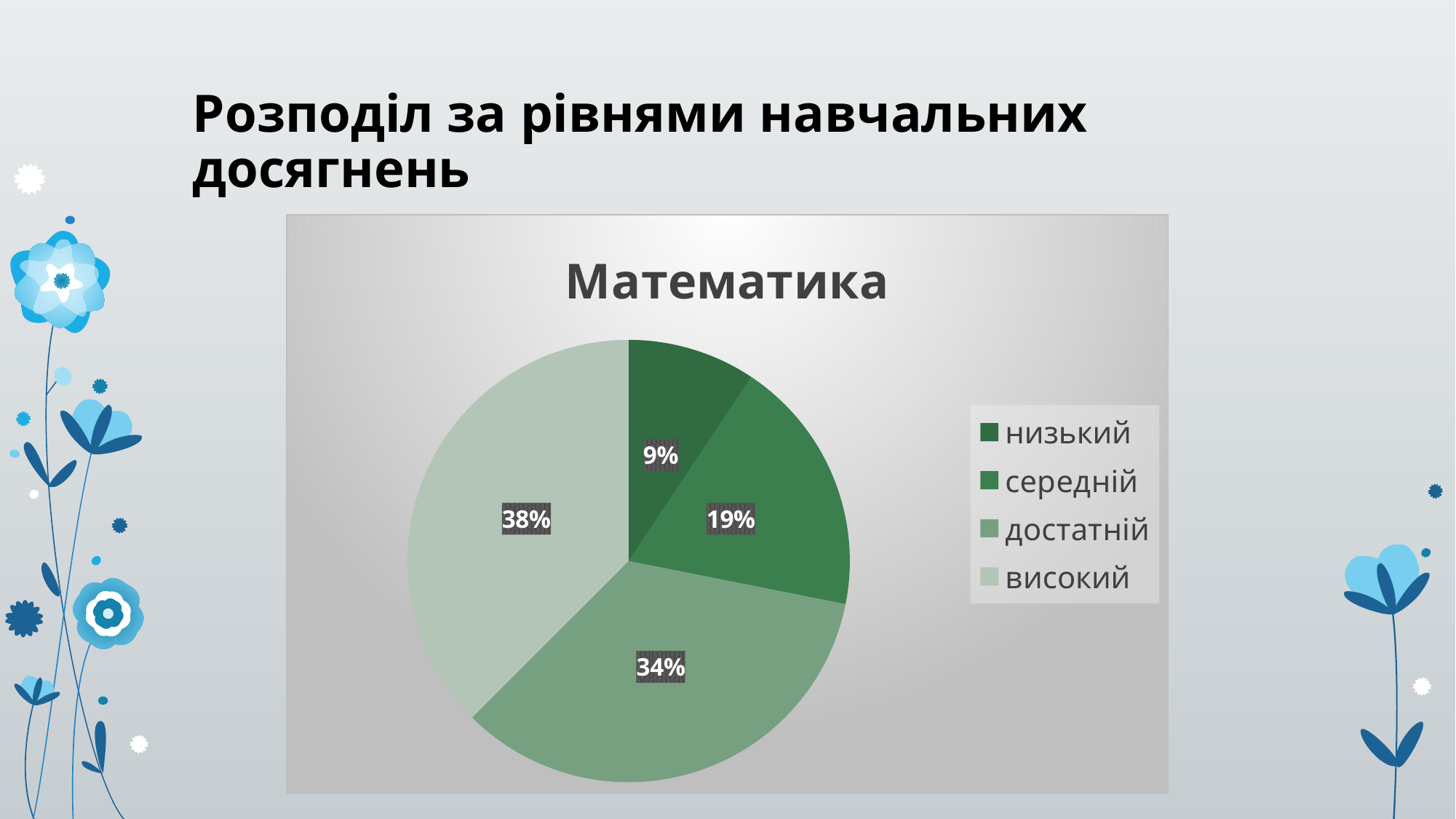
What share of the pie does the 'високий' slice represent? 38% Which category has the largest slice of the pie? високий Which category has the smallest slice of the pie? низький How many categories does the legend list? 4 What is the difference between the 'середній' and 'низький' shares? 10% What share of the pie does the 'достатній' slice represent? 34% What share of the pie does the 'низький' slice represent? 9% What type of chart is shown on the slide? pie chart Which is larger, the 'середній' slice or the 'достатній' slice? достатній What is the title of the chart? Математика What is the difference between the 'високий' and 'достатній' shares? 4%